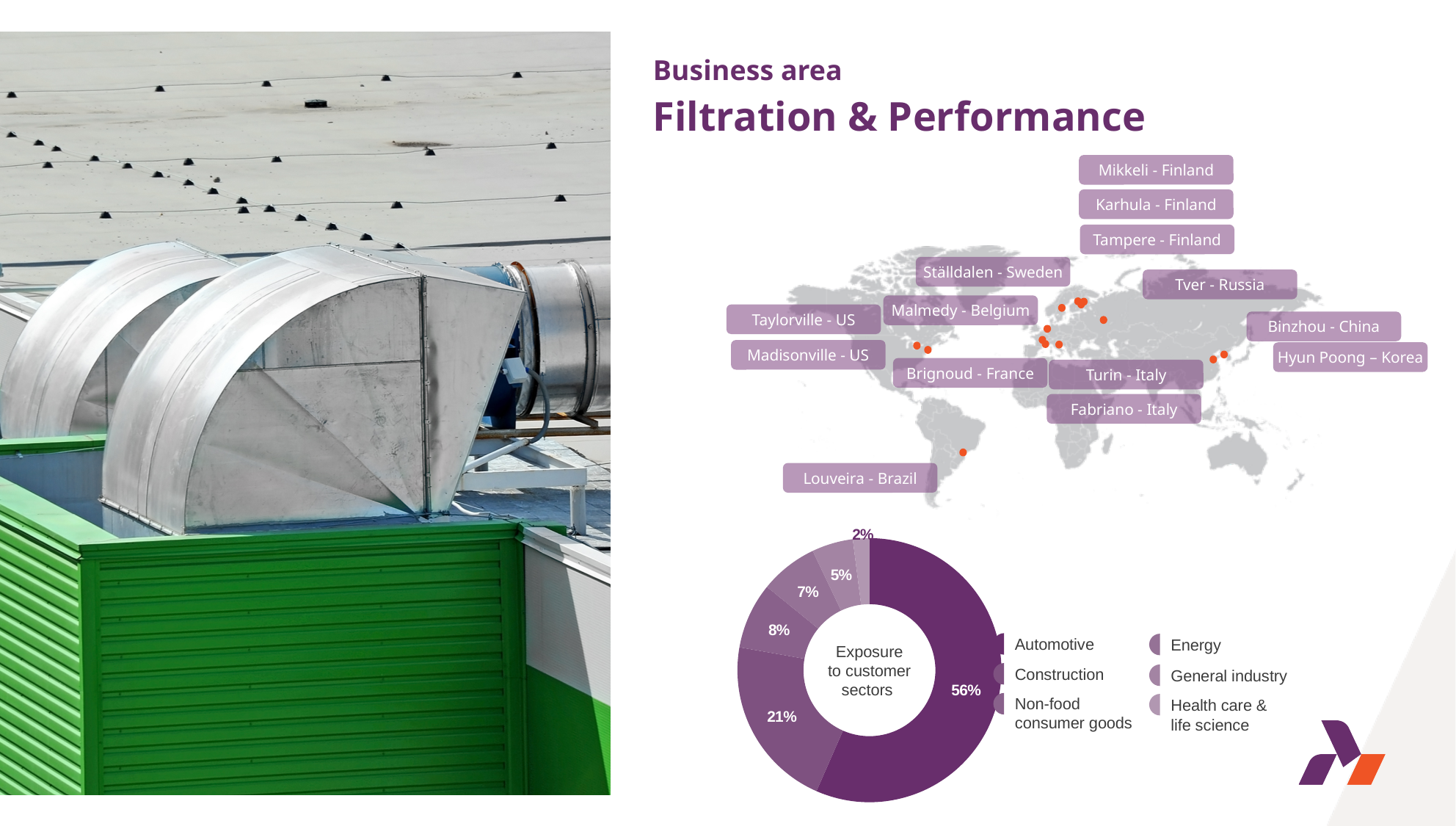
How many customer sectors are listed in the legend of the 'Exposure to customer sectors' chart? 6 What is the title shown in the centre of the donut chart? Exposure to customer sectors In the 'Exposure to customer sectors' chart, what is the combined share of the two largest slices (56% and 21%)? 77% How many slices does the 'Exposure to customer sectors' chart have? 6 In the 'Exposure to customer sectors' chart, which is larger: the 8% slice or the 7% slice? the 8% slice In the 'Exposure to customer sectors' chart, what is the smallest slice's value? 2% In the 'Exposure to customer sectors' chart, what share does Automotive have? 56% In the 'Exposure to customer sectors' chart, is the Automotive share greater or less than 50%? greater What kind of chart is shown at the bottom of the slide? pie chart (donut) In the 'Exposure to customer sectors' chart, what is the largest slice's value? 56%